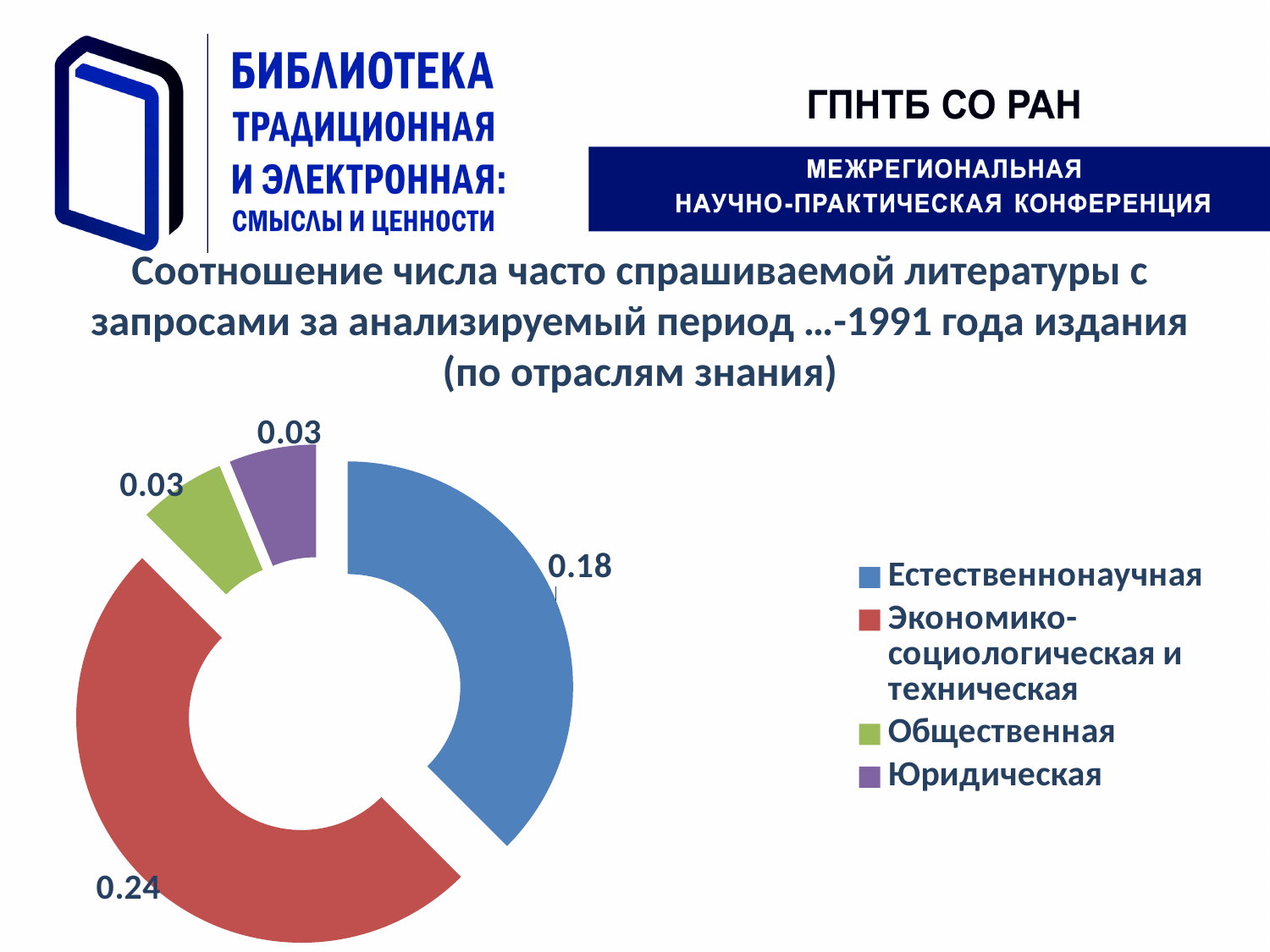
How many entries does the legend list? 4 What colour represents Юридическая in the chart? purple Which category has the highest value? Экономико-социологическая и техническая What value is shown for Естественнонаучная? 0.18 What value is shown for Юридическая? 0.03 What value is shown for Экономико-социологическая и техническая? 0.24 What kind of chart is shown on the slide? doughnut chart What value is shown for Общественная? 0.03 What is the difference between the values for Естественнонаучная and Юридическая? 0.15 What is the difference between the values for Экономико-социологическая и техническая and Естественнонаучная? 0.06 How many categories are shown in the chart? 4 Which is larger, the value for Естественнонаучная or the value for Общественная? Естественнонаучная